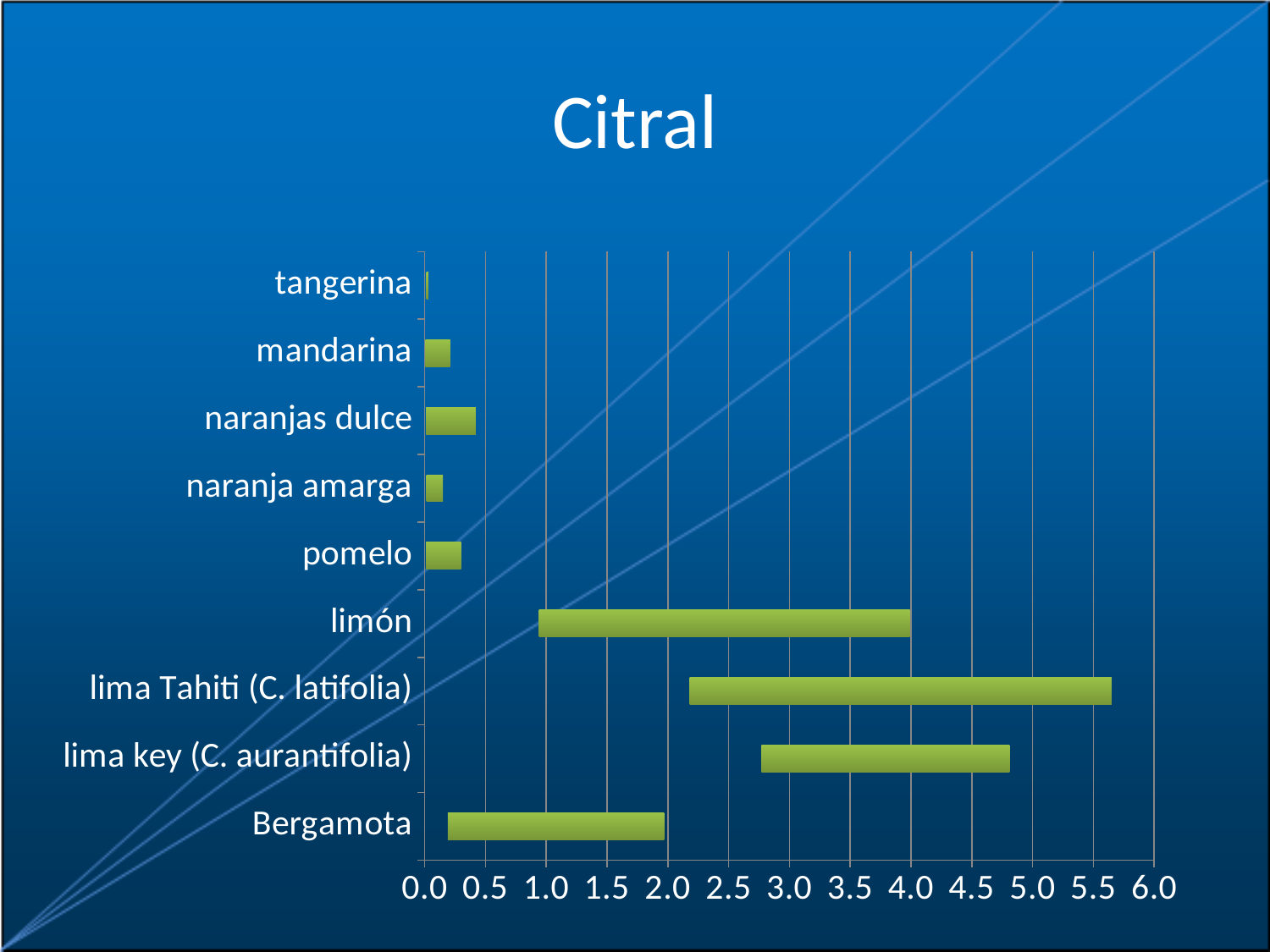
How many categories are listed on the vertical axis of the chart? 9 Which category's bar extends to the highest value on the horizontal axis? lima Tahiti (C. latifolia) What is the title of the chart? Citral Is the lower end of the bar for lima key (C. aurantifolia) greater or less than 2.5? greater What kind of chart is shown on the slide? bar chart Is the lower end of the bar for Bergamota greater or less than 0.5? less What is the maximum value shown on the horizontal axis? 6.0 Is the upper end of the bar for lima key (C. aurantifolia) greater or less than 5.0? less Which bar is longer, mandarina or naranjas dulce? naranjas dulce Which category has the smallest bar in the chart? tangerina